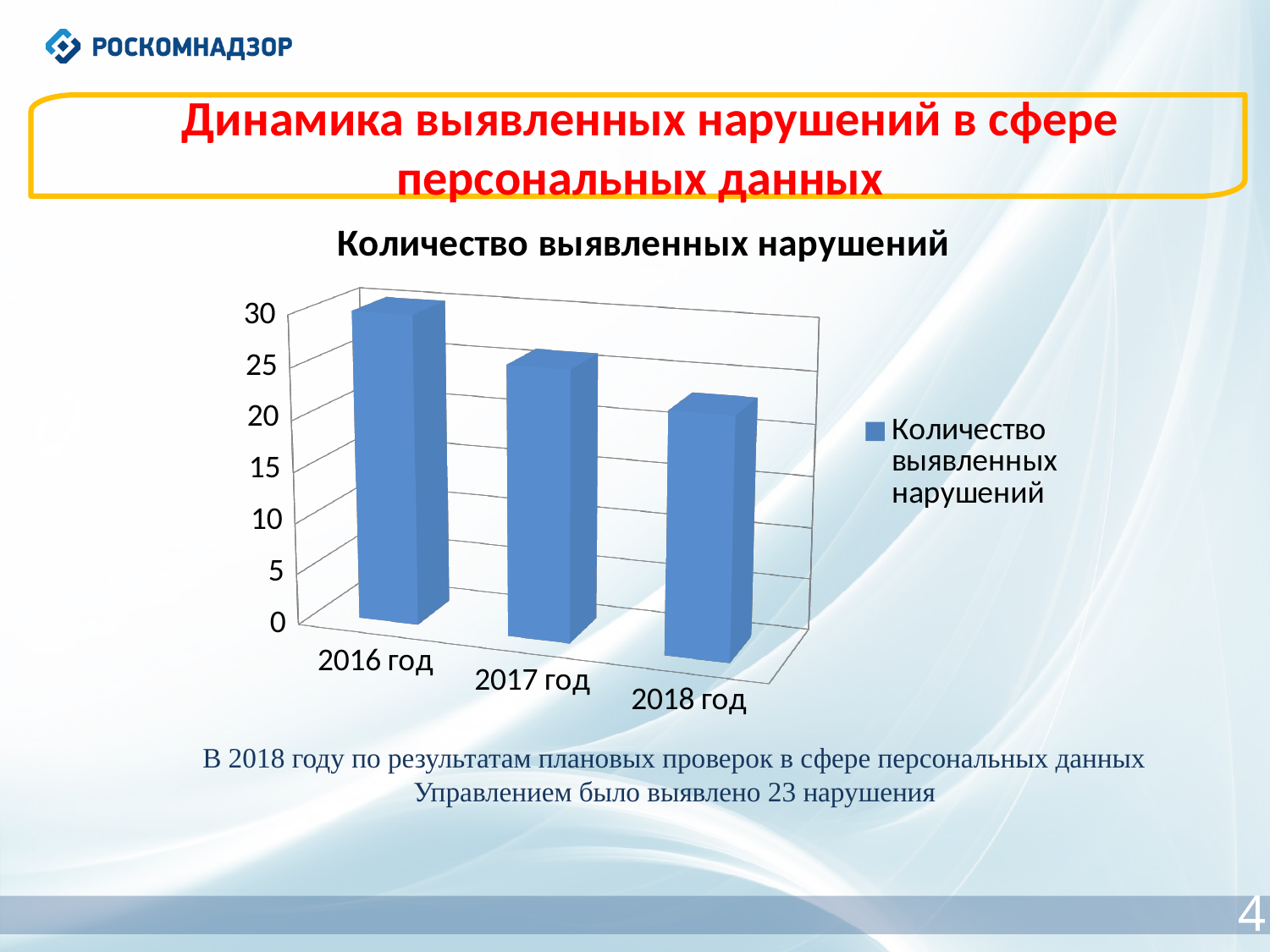
What is the title of the chart? Количество выявленных нарушений Is the value for 2016 год greater or less than 25? greater Which year has the lowest number of identified violations? 2018 год Which is larger, the value for 2016 год or the value for 2018 год? 2016 год Which is larger, the value for 2017 год or the value for 2018 год? 2017 год What is the legend entry of the series in the chart? Количество выявленных нарушений Do the values rise or fall from 2016 to 2018? fall How many years (categories) are shown on the x axis of the chart? 3 What kind of chart is shown on the slide? bar chart Is the value for 2018 год greater or less than 25? less How many series does the chart legend list? 1 Which year has the highest number of identified violations? 2016 год